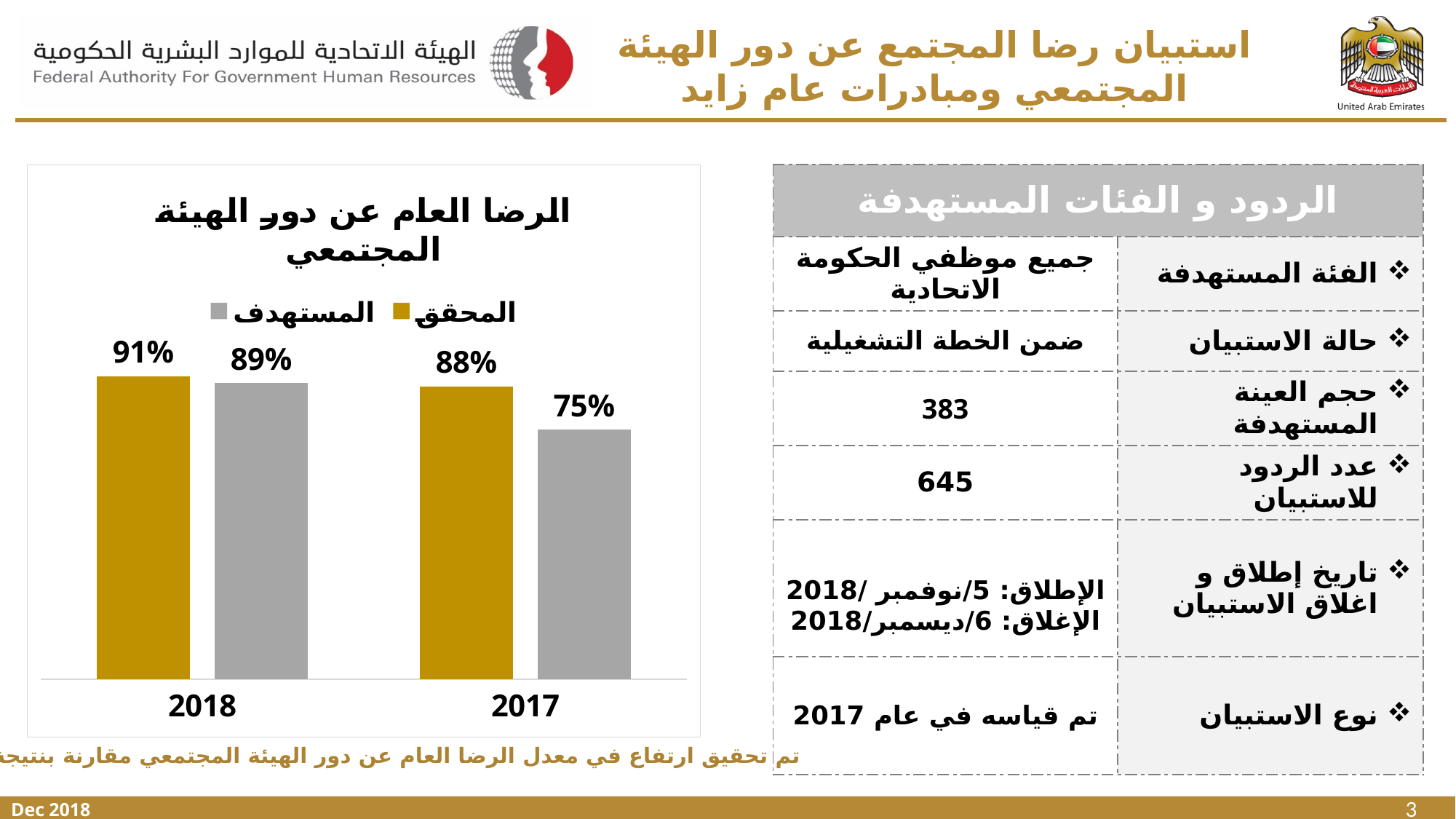
What colour are the المحقق (achieved) bars? Gold What is the value of المستهدف (target) for 2017? 75% What is the value of المحقق (achieved) for 2017? 88% How many series does the chart legend list? 2 Which year has the highest المحقق (achieved) value? 2018 What is the difference between المحقق (achieved) and المستهدف (target) for 2017? 13% What is the value of المحقق (achieved) for 2018? 91% Which is larger for 2018: المحقق (achieved) or المستهدف (target)? المحقق What kind of chart is shown on the slide? Bar chart What is the difference between the المحقق (achieved) values for 2018 and 2017? 3% What is the value of المستهدف (target) for 2018? 89% Which year has the lowest المستهدف (target) value? 2017